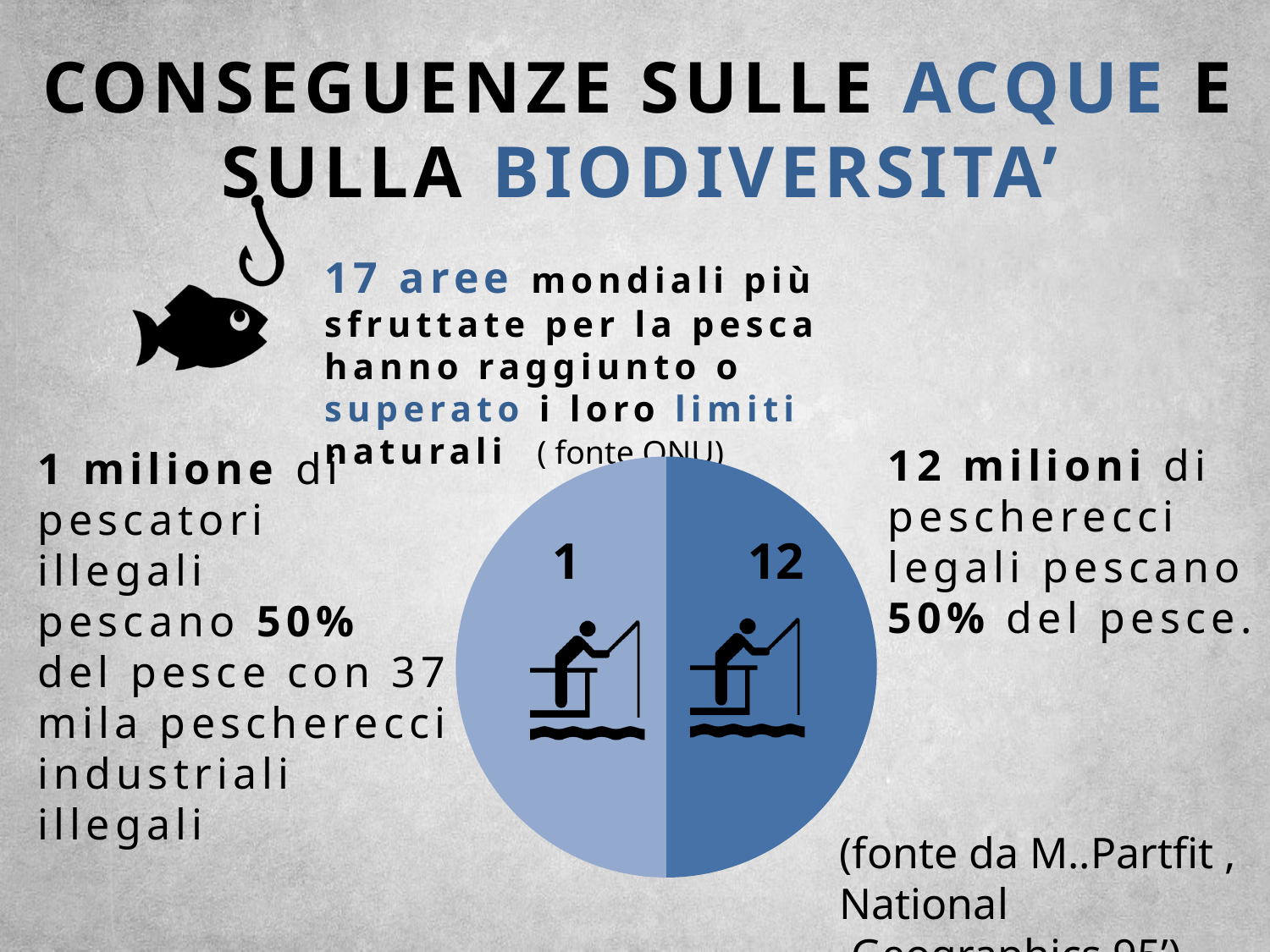
What label is printed on the right slice of the pie chart? 12 How many slices does the pie chart have? 2 Which slice of the pie chart is drawn in the darker blue, the one labelled 1 or the one labelled 12? the one labelled 12 What is the difference between the two numbers printed on the pie chart slices? 11 Are the two slices of the pie chart drawn as equal halves or as unequal portions? equal halves What kind of chart is shown on the slide? pie chart What icon is shown inside each slice of the pie chart? a person fishing with a rod What label is printed on the left slice of the pie chart? 1 Which slice of the pie chart carries the larger printed number, the left one or the right one? the right one (12)